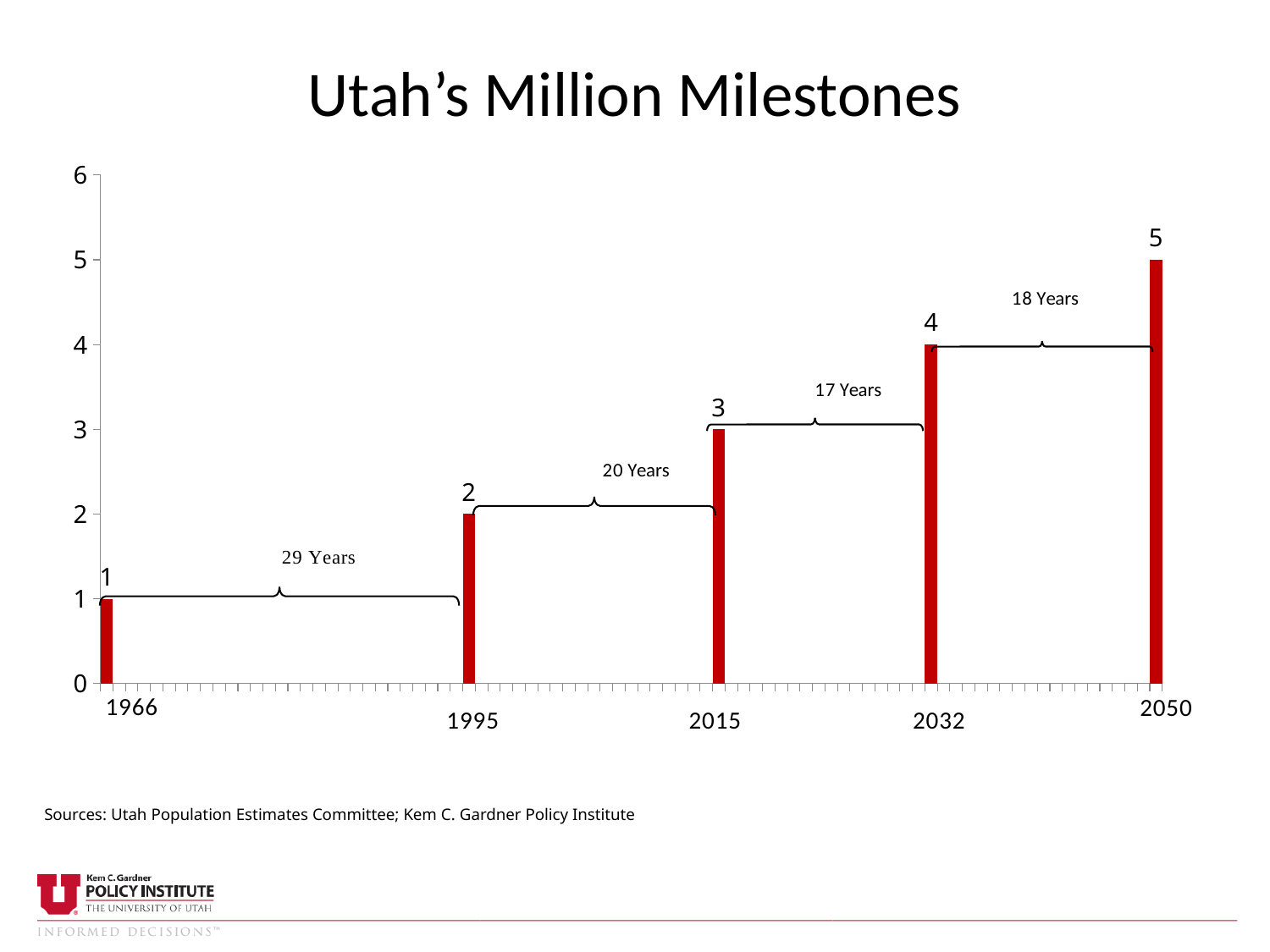
What is the title of the chart? Utah's Million Milestones How many years does the bracket between 1966 and 1995 indicate? 29 Years Which year has the lowest value? 1966 Which is larger, the value for 2015 or the value for 1995? 2015 What is the value for 1966? 1 Do the values rise or fall from 1966 to 2050? Rise What is the difference between the values for 2032 and 1995? 2 Which year has the highest value? 2050 What is the value for 2015? 3 What kind of chart is shown? Bar chart How many bars are plotted in the chart? 5 What is the value for 2050? 5